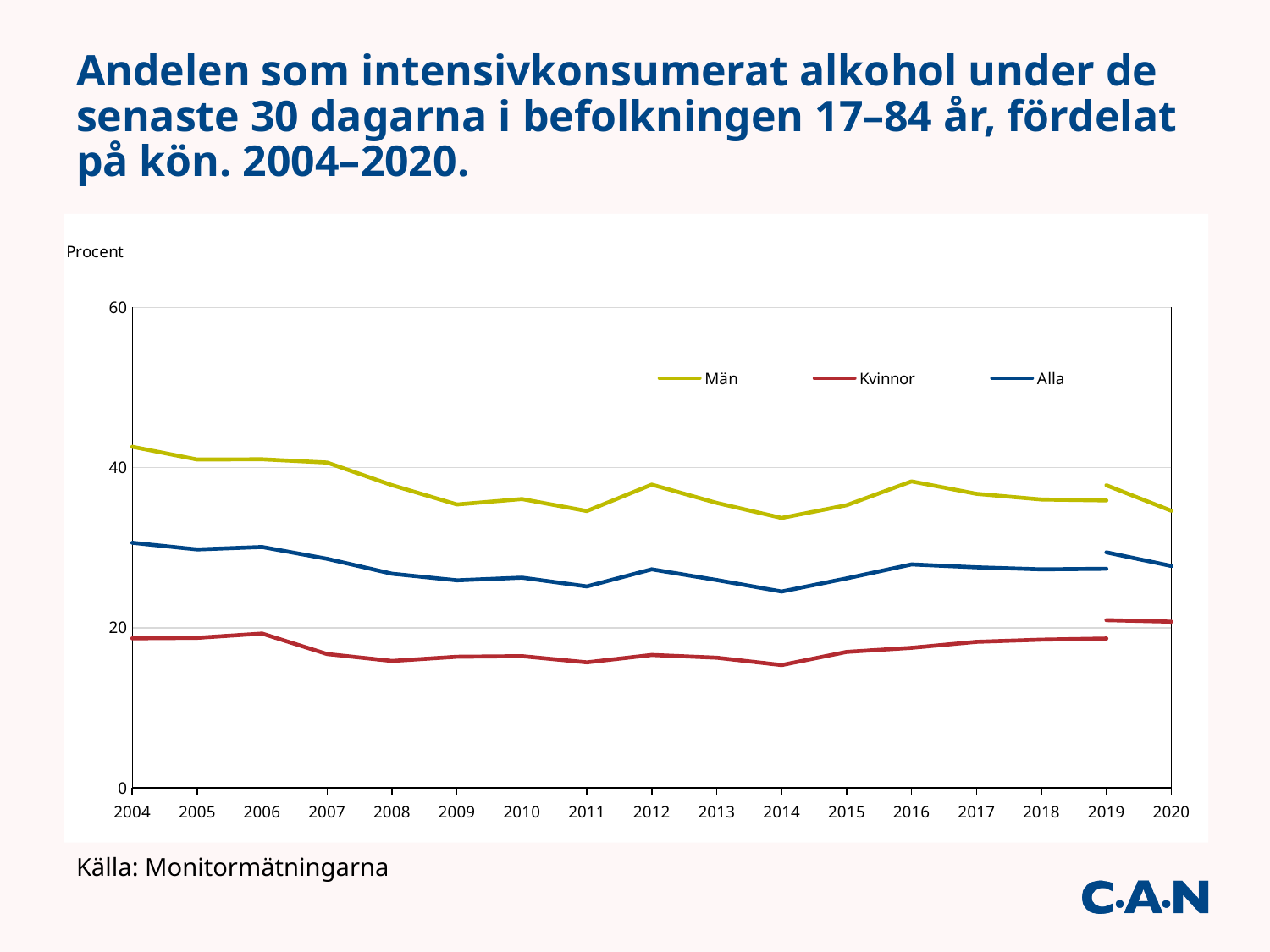
Is the value for Män in 2004 greater or less than 40? greater What is the label on the y axis? Procent How many series does the legend list? 3 How many years are shown on the x axis? 17 Is the value for Alla in 2014 greater or less than 20? greater In which year is the value for Män highest? 2004 Which series are listed in the legend? Män, Kvinnor, Alla Is the value for Män in 2014 greater or less than 40? less In 2010, which series has the larger value, Män or Kvinnor? Män What kind of chart is shown on the slide? line chart Does the value for Män rise or fall from 2004 to 2009? fall